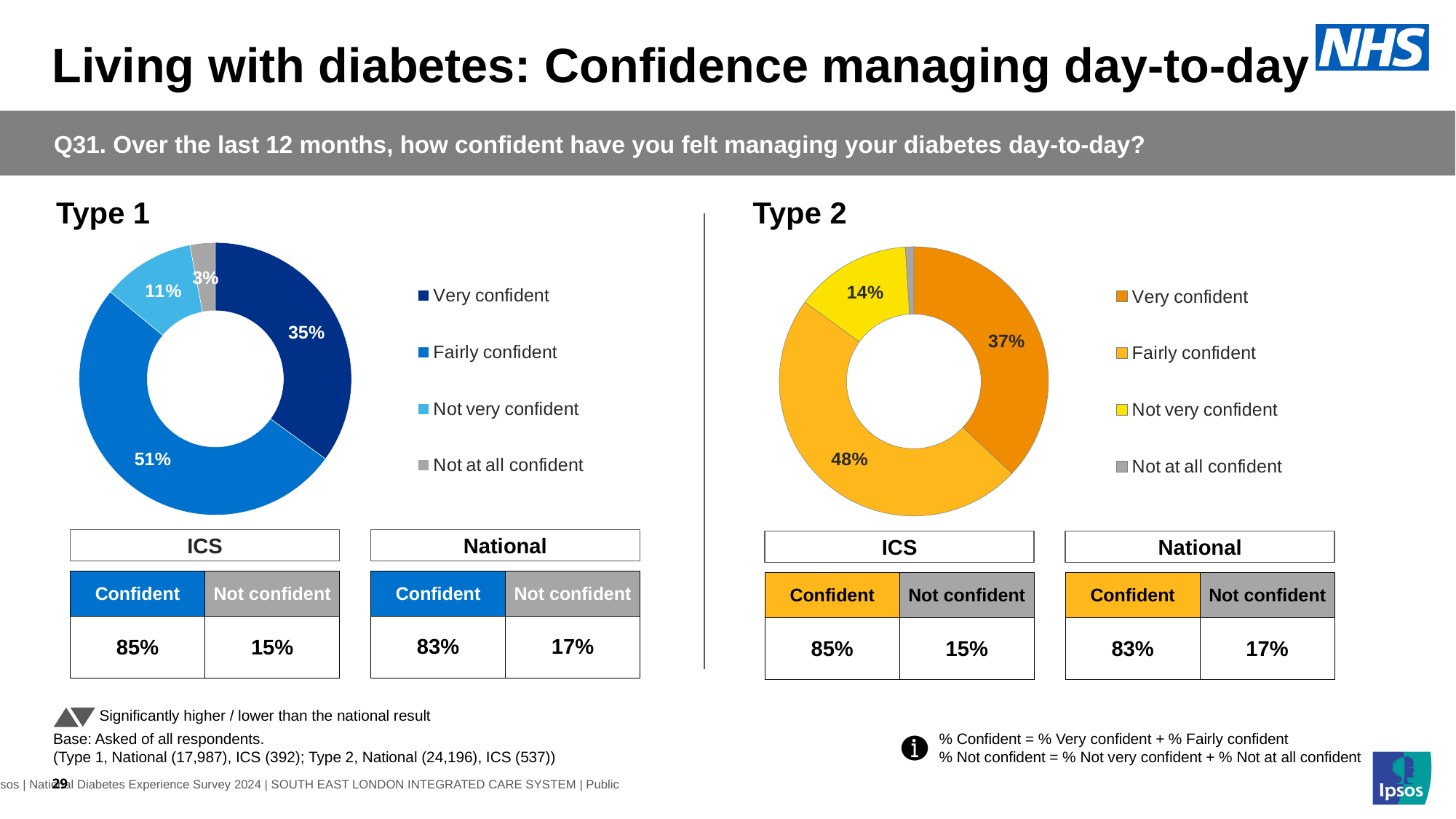
In the Type 1 chart, what percentage of respondents were fairly confident? 51% How many categories does the legend of the Type 2 chart list? 4 In the Type 2 chart, what percentage of respondents were not very confident? 14% In the Type 2 chart, what percentage of respondents were fairly confident? 48% In the Type 2 chart, which category has the smallest share? Not at all confident What kind of chart is used for Type 1? Donut (pie) chart In the Type 1 chart, what is the difference between the fairly confident and very confident shares? 16 percentage points In the Type 1 chart, which category has the largest share? Fairly confident Which is larger: the very confident share in the Type 1 chart or in the Type 2 chart? Type 2 In the Type 1 chart, what percentage of respondents were very confident? 35% In the Type 1 chart, what percentage of respondents were not at all confident? 3% In the Type 1 chart, what colour represents the not very confident category? Light blue